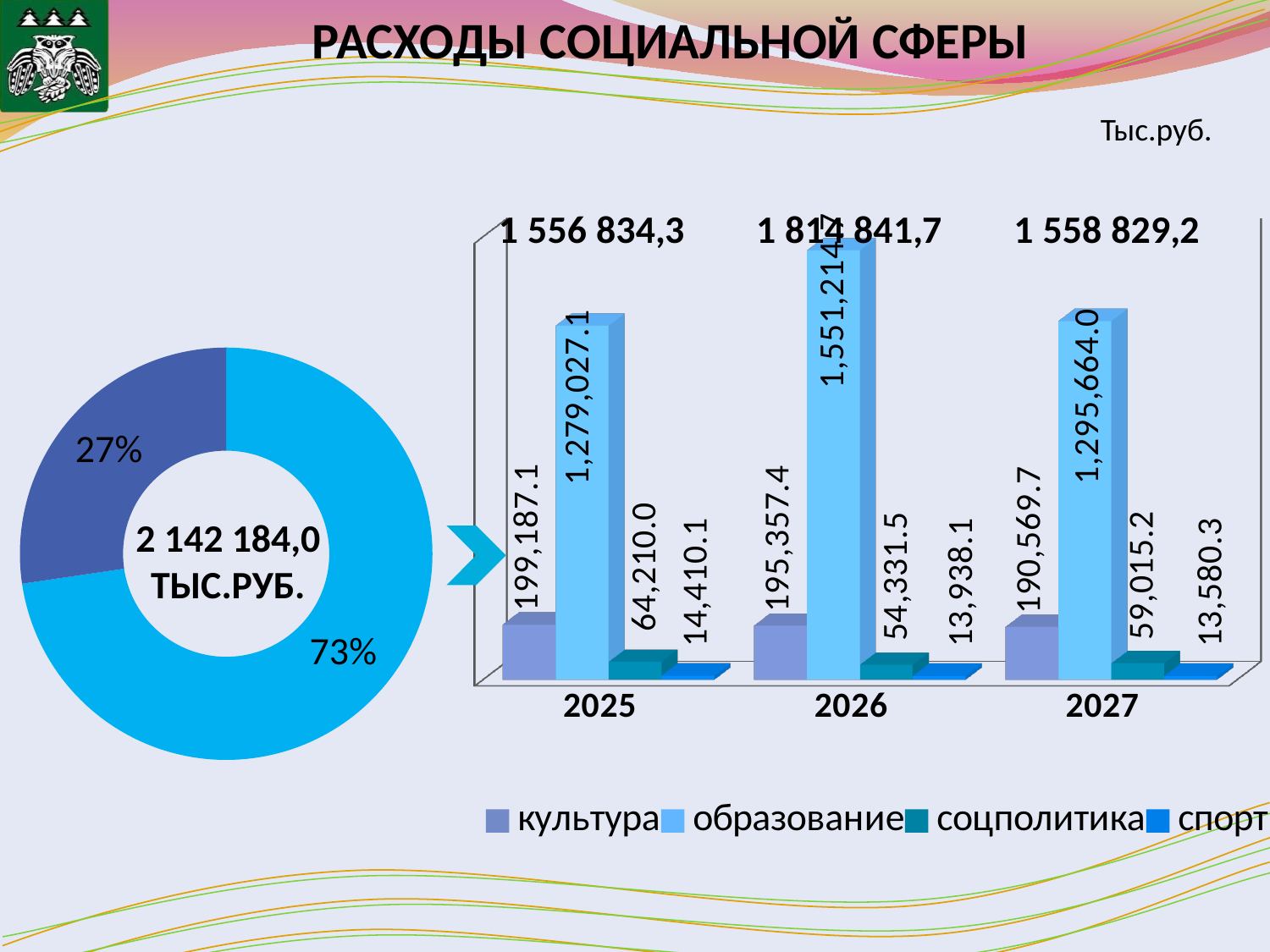
In the bar chart on the right, what is the value for образование in 2026? 1,551,214.7 In the bar chart on the right, what is the difference between the соцполитика values for 2025 and 2027? 5,194.8 In the bar chart on the right, what is the value for культура in 2025? 199,187.1 In the bar chart on the right, which is larger: культура in 2025 or культура in 2027? культура in 2025 In the donut chart on the left, what percentage is shown for the larger slice? 73% In the bar chart on the right, what is the value for соцполитика in 2026? 54,331.5 In the bar chart on the right, how many years are shown on the x axis? 3 What kind of chart is shown on the left of the slide? Donut (pie) chart In the bar chart on the right, what is the value for спорт in 2027? 13,580.3 In the bar chart on the right, how many series does the legend list? 4 In the bar chart on the right, which year has the highest value for образование? 2026 In the bar chart on the right, which year has the lowest value for спорт? 2027